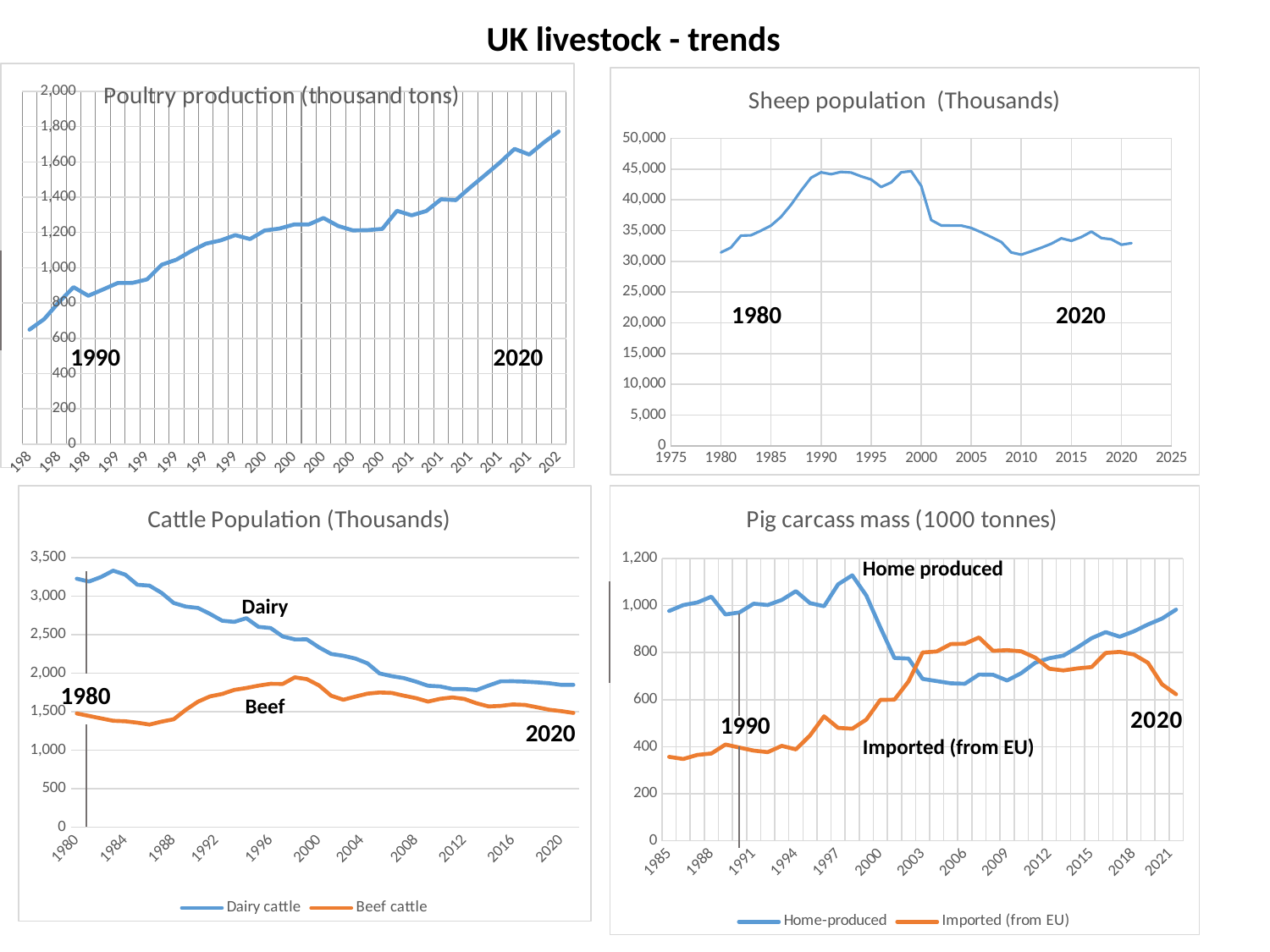
In the 'Sheep population (Thousands)' chart, is the value for 1990 greater or less than 40,000? greater In the 'Poultry production (thousand tons)' chart, do the values generally rise or fall from 1990 to 2020? rise In the 'Pig carcass mass (1000 tonnes)' chart, is the Imported (from EU) value for 1985 greater or less than 400? less In the 'Sheep population (Thousands)' chart, is the value for 1980 greater or less than 35,000? less In the 'Cattle Population (Thousands)' chart, does the Dairy cattle series rise or fall from 1980 to 2020? fall What kind of chart is the 'Poultry production (thousand tons)' chart? line chart How many series does the legend of the 'Pig carcass mass (1000 tonnes)' chart list? 2 In the 'Cattle Population (Thousands)' chart, which series has the larger value in 1980, Dairy cattle or Beef cattle? Dairy cattle In the 'Pig carcass mass (1000 tonnes)' chart, which series has the larger value in 2021, Home-produced or Imported (from EU)? Home-produced How many series does the legend of the 'Cattle Population (Thousands)' chart list? 2 What are the two legend entries of the 'Pig carcass mass (1000 tonnes)' chart? Home-produced and Imported (from EU)